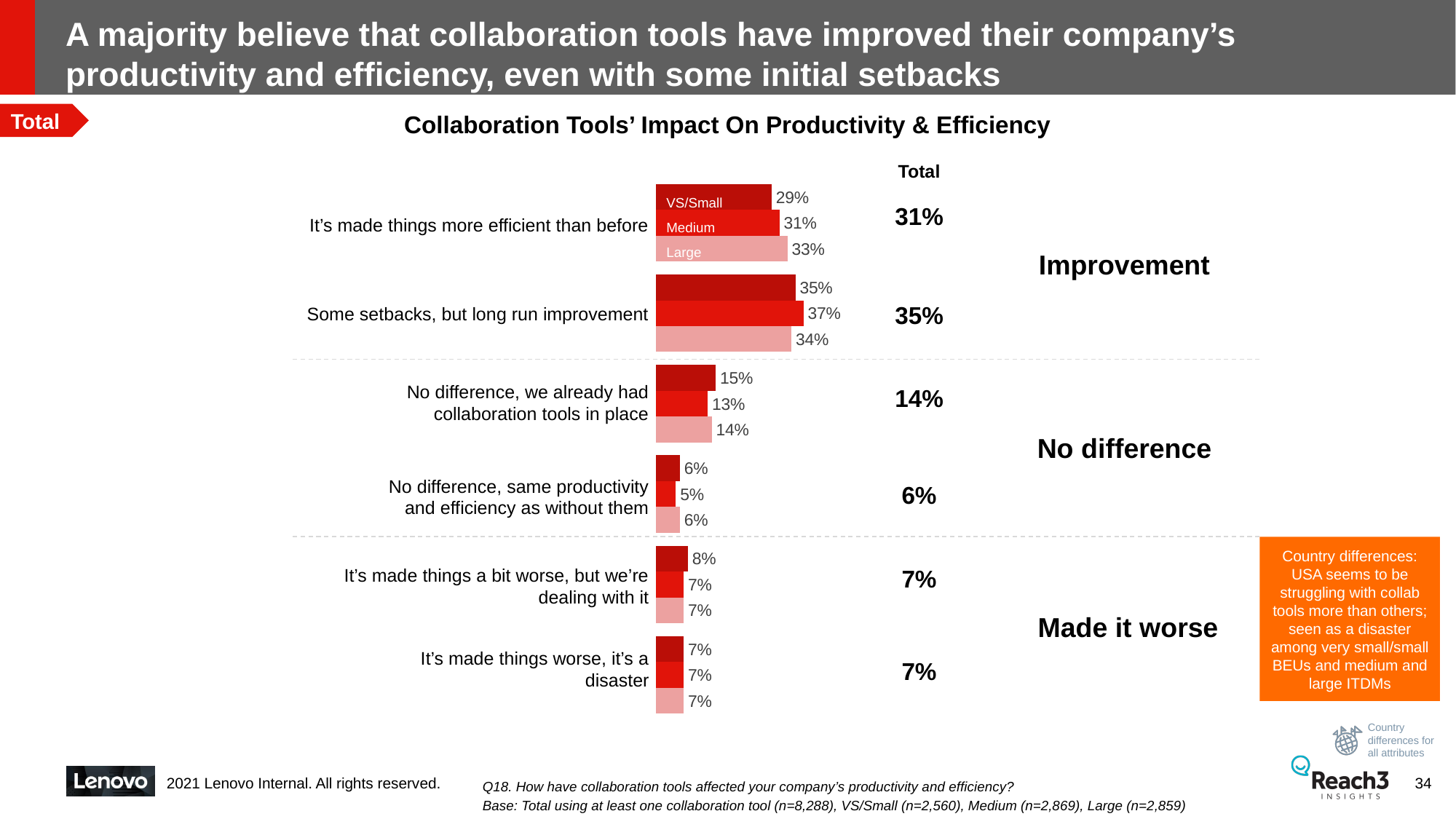
What is the difference between the Large and VS/Small values for "It's made things more efficient than before"? 4% How many company-size series are shown for each category? 3 What is the VS/Small value for "No difference, we already had collaboration tools in place"? 15% What is the title of the chart? Collaboration Tools' Impact On Productivity & Efficiency What is the Medium value for "Some setbacks, but long run improvement"? 37% Which category has the lowest Total value? No difference, same productivity and efficiency as without them Which category has the highest Total value? Some setbacks, but long run improvement What is the Total value for "Some setbacks, but long run improvement"? 35% What is the Large value for "It's made things more efficient than before"? 33% For "Some setbacks, but long run improvement", which is larger: the Medium value or the Large value? Medium What type of chart is shown on the slide? Bar chart How many response categories are shown in the chart? 6